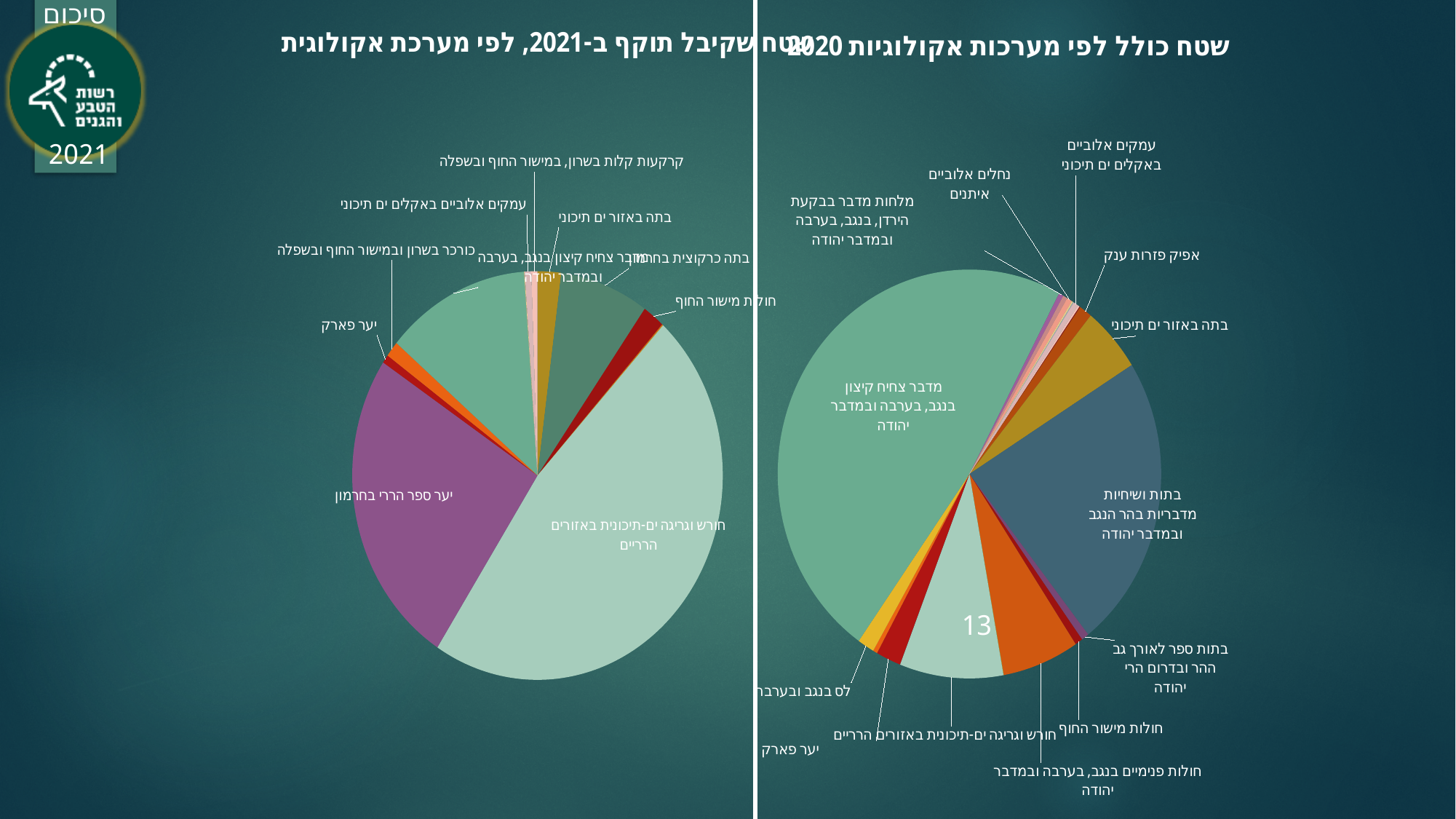
In the right chart (שטח כולל לפי מערכות אקולוגיות 2020), which ecosystem has the largest slice? מדבר צחיח קיצון בנגב, בערבה ובמדבר יהודה In the right chart (שטח כולל לפי מערכות אקולוגיות 2020), which slice is larger: 'בתות ושיחיות מדבריות בהר הנגב ובמדבר יהודה' or 'חורש וגריגה ים-תיכונית באזורים הרריים'? בתות ושיחיות מדבריות בהר הנגב ובמדבר יהודה What kind of chart is the left chart, titled 'שטח שקיבל תוקף ב-2021, לפי מערכת אקולוגית'? Pie chart In the right chart (שטח כולל לפי מערכות אקולוגיות 2020), which slice is larger: 'חולות פנימיים בנגב, בערבה ובמדבר יהודה' or 'חולות מישור החוף'? חולות פנימיים בנגב, בערבה ובמדבר יהודה In the left chart (שטח שקיבל תוקף ב-2021), which ecosystem has the largest slice? חורש וגריגה ים-תיכונית באזורים הרריים In the left chart (שטח שקיבל תוקף ב-2021), which slice is larger: 'מדבר צחיח קיצון בנגב, בערבה ובמדבר יהודה' or 'חולות מישור החוף'? מדבר צחיח קיצון בנגב, בערבה ובמדבר יהודה What kind of chart is the right chart, titled 'שטח כולל לפי מערכות אקולוגיות 2020'? Pie chart What is the title of the left chart on the slide? שטח שקיבל תוקף ב-2021, לפי מערכת אקולוגית Which year appears in the title of the right chart? 2020